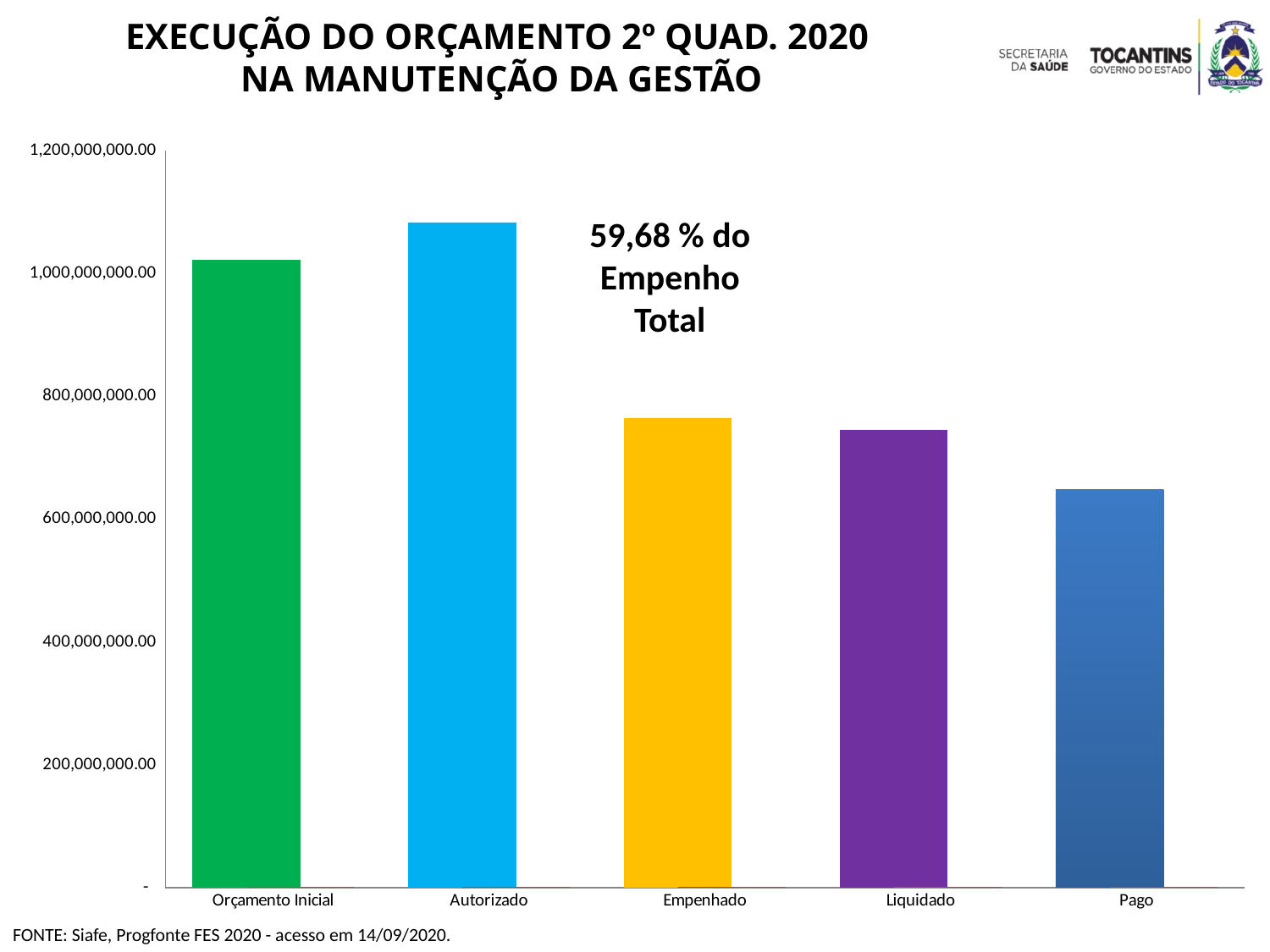
Is the value for Empenhado greater or less than 800,000,000.00? less Which category has the highest bar in the chart? Autorizado Is the value for Orçamento Inicial greater or less than 1,000,000,000.00? greater What is the title of the chart on the slide? EXECUÇÃO DO ORÇAMENTO 2º QUAD. 2020 NA MANUTENÇÃO DA GESTÃO Which is larger, the value for Autorizado or the value for Orçamento Inicial? Autorizado How many categories are plotted on the x axis of the chart? 5 What kind of chart is shown on the slide? Bar chart What percentage of the Empenho Total is stated in the text annotation on the chart? 59,68 % Which category has the lowest bar in the chart? Pago Is the value for Pago greater or less than 600,000,000.00? greater Which is larger, the value for Empenhado or the value for Pago? Empenhado